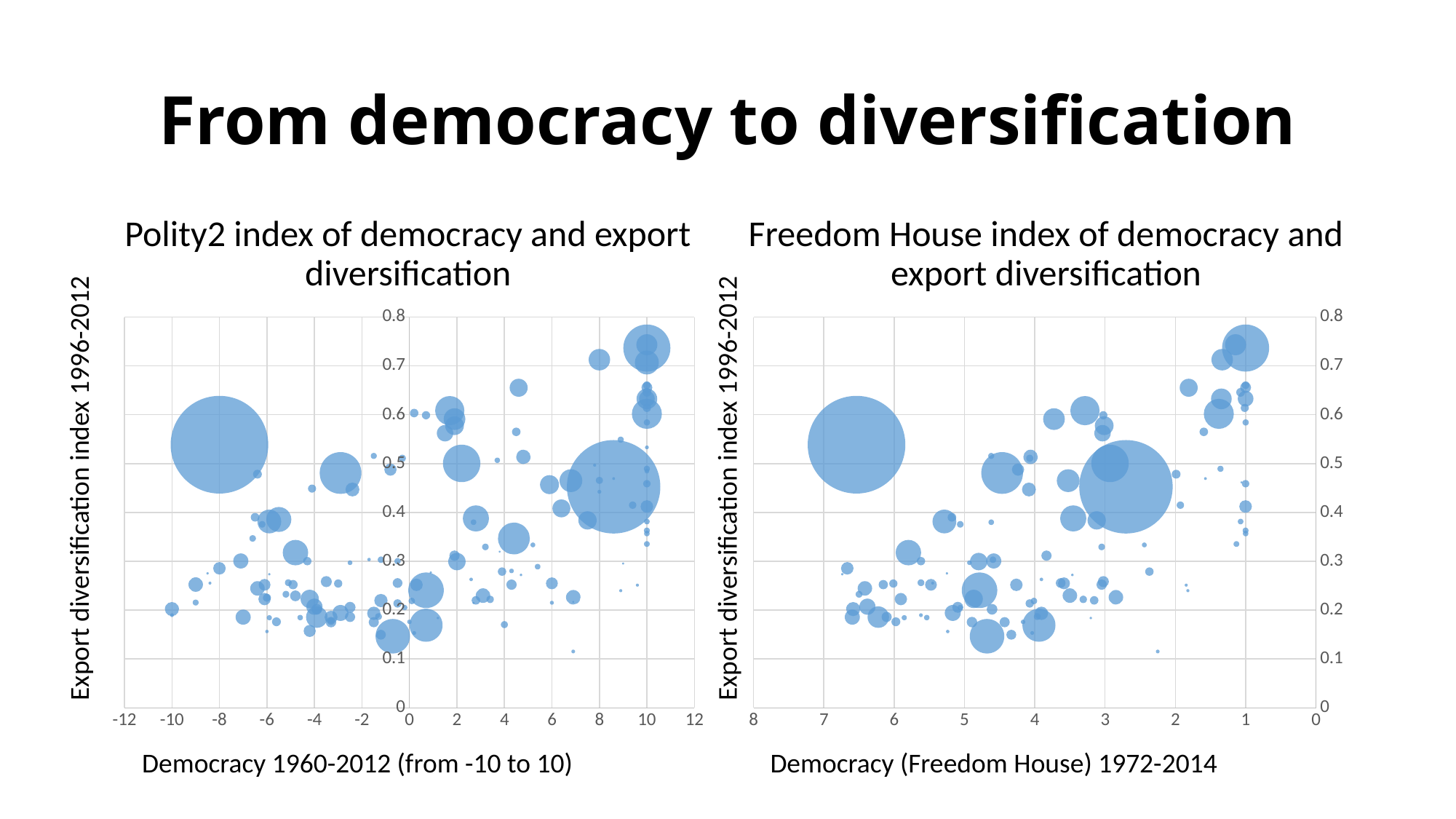
How many charts are shown on the slide? 2 What kind of chart is the right chart, titled 'Freedom House index of democracy and export diversification'? Bubble chart What is the x-axis label of the left chart? Democracy 1960-2012 (from -10 to 10) In the right chart (Freedom House), do the bubbles generally rise or fall moving from left to right along the x axis? Rise What is the maximum value shown on the y axis of the left chart (Polity2)? 0.8 In the left chart (Polity2), do export diversification values generally rise or fall as the democracy index increases from -10 to 10? Rise What kind of chart is the left chart, titled 'Polity2 index of democracy and export diversification'? Bubble chart What is the title of the right chart? Freedom House index of democracy and export diversification